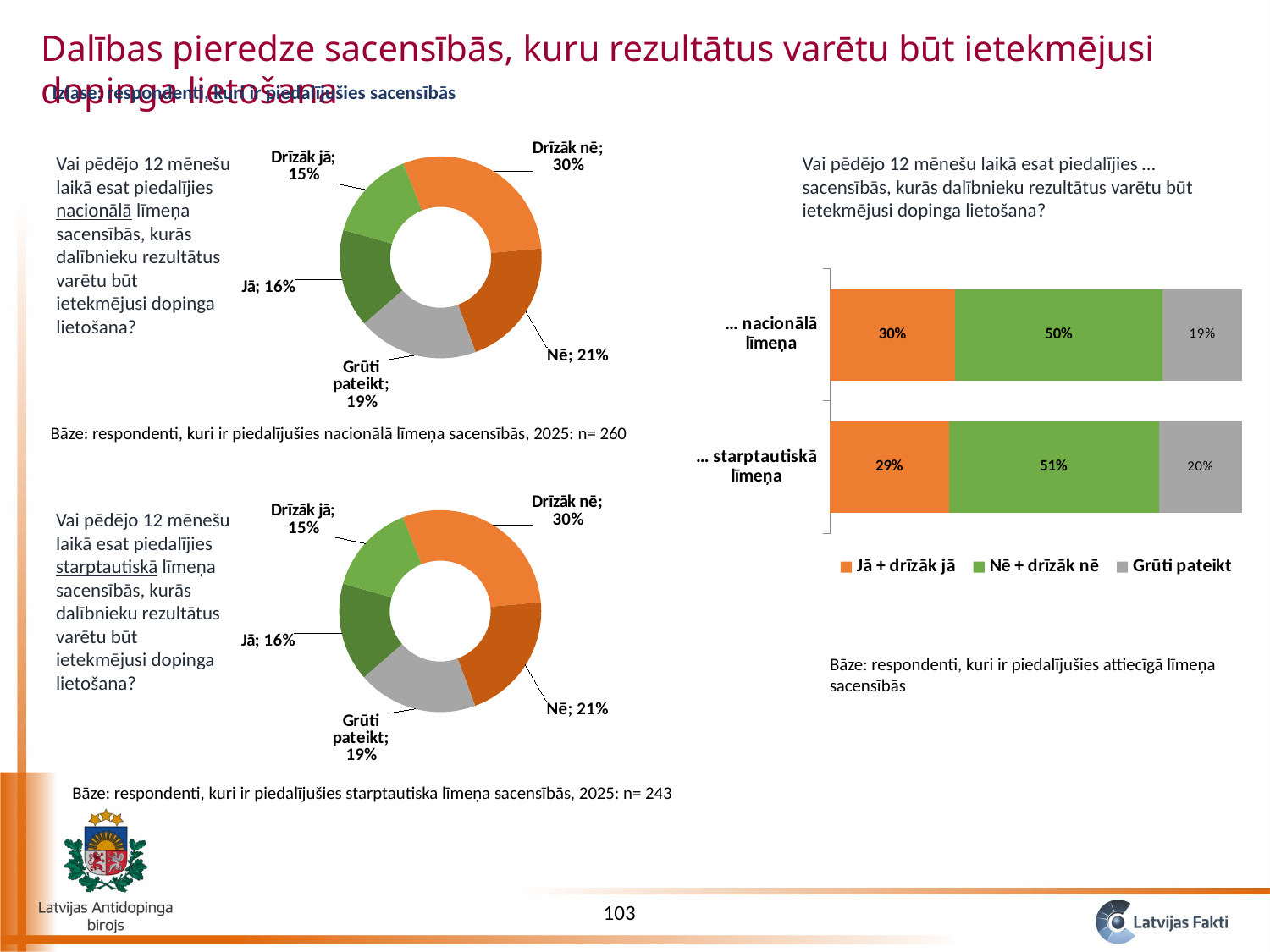
In the stacked bar chart on the right, what is the value of "Jā + drīzāk jā" for "... nacionālā līmeņa"? 30% In the bottom-left donut chart (starptautiskā līmeņa), which answer has the largest share? Drīzāk nē How many series does the legend of the stacked bar chart on the right list? 3 What type of chart is shown on the right side of the slide? Stacked bar chart In the top-left donut chart (nacionālā līmeņa), what is the difference between the shares for "Nē" and "Jā"? 5 percentage points In the top-left donut chart (nacionālā līmeņa), what share of respondents answered "Drīzāk nē"? 30% In the top-left donut chart (nacionālā līmeņa), which answer has the smallest share? Drīzāk jā In the stacked bar chart on the right, what is the difference between the "Grūti pateikt" values for "... starptautiskā līmeņa" and "... nacionālā līmeņa"? 1 percentage point How many slices does the top-left donut chart (nacionālā līmeņa) have? 5 In the bottom-left donut chart (starptautiskā līmeņa), which is larger: the share for "Jā" or the share for "Drīzāk jā"? Jā In the stacked bar chart on the right, what is the value of "Nē + drīzāk nē" for "... starptautiskā līmeņa"? 51% In the bottom-left donut chart (starptautiskā līmeņa), what share of respondents answered "Grūti pateikt"? 19%